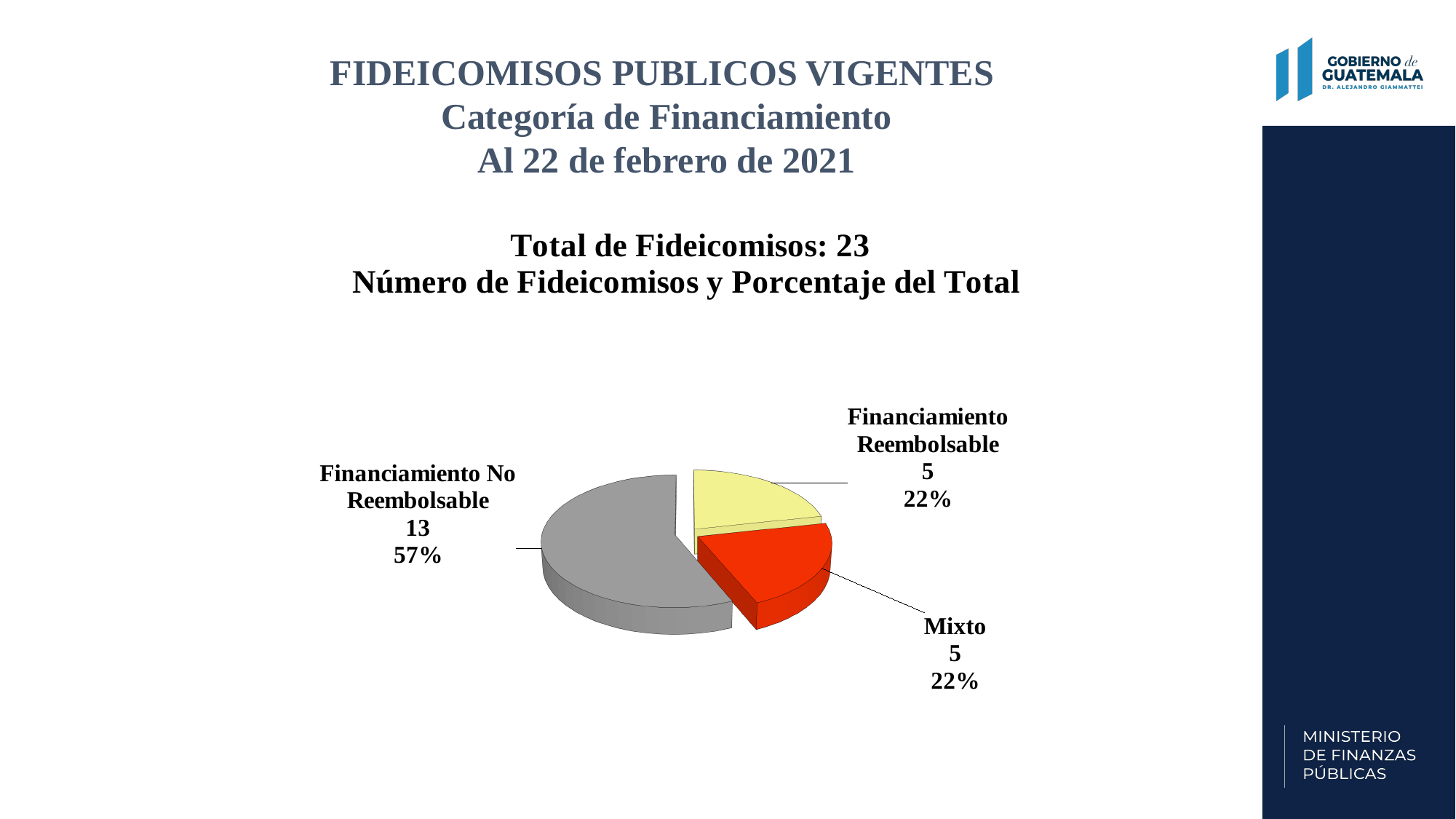
How many fideicomisos are in the Financiamiento Reembolsable category? 5 How many slices does the pie chart have? 3 What is the difference in the number of fideicomisos between Financiamiento No Reembolsable and Mixto? 8 What colour is the Mixto slice of the pie chart? red What kind of chart is shown on the slide? pie chart What share of the total does Financiamiento No Reembolsable represent? 57% How many fideicomisos are in the Mixto category? 5 How many fideicomisos are in the Financiamiento No Reembolsable category? 13 What share of the total does Mixto represent? 22% Which category has the largest number of fideicomisos? Financiamiento No Reembolsable What is the total number of fideicomisos stated on the slide? 23 Which is larger, the number of fideicomisos for Financiamiento No Reembolsable or for Financiamiento Reembolsable? Financiamiento No Reembolsable